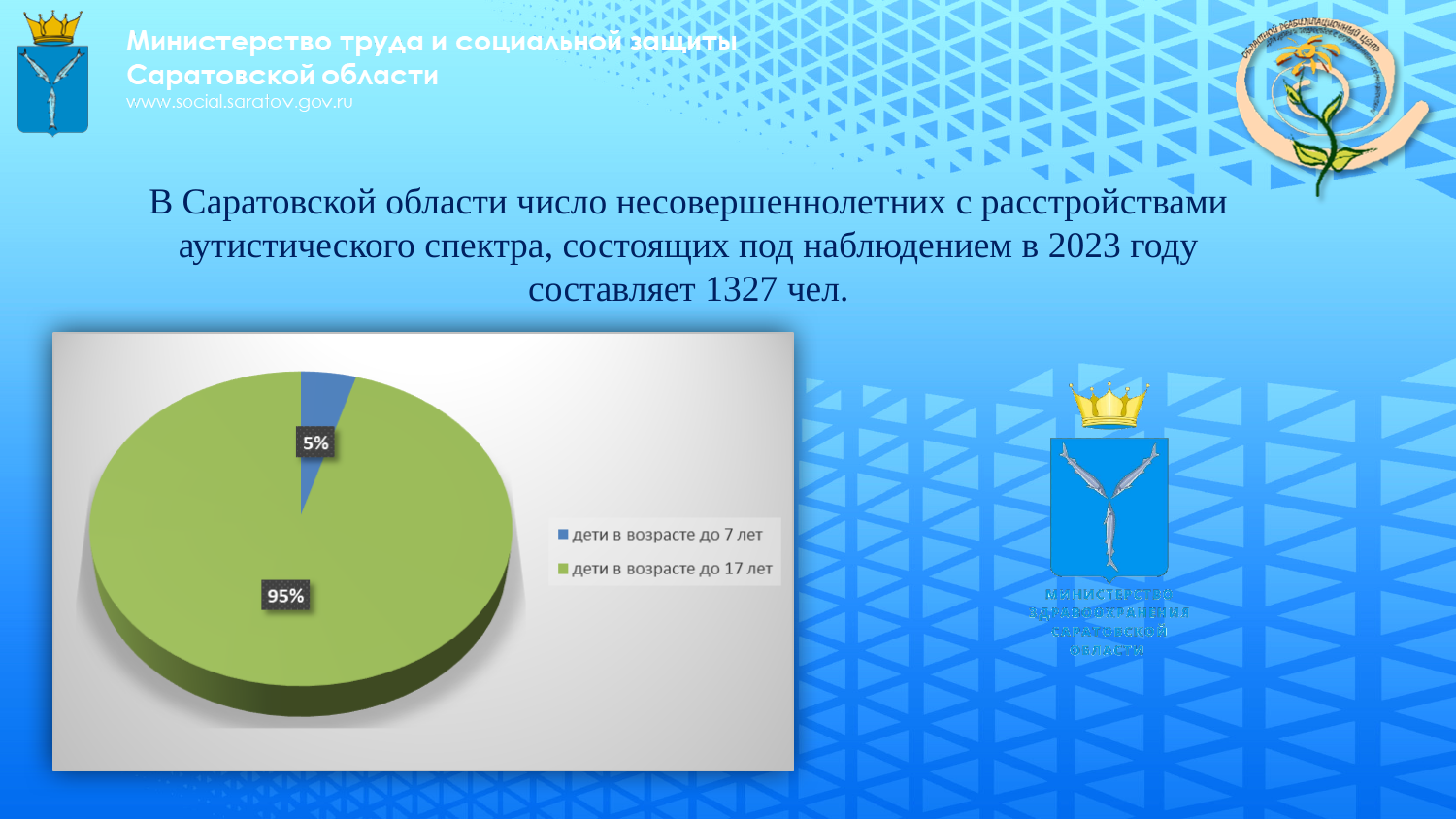
What kind of chart is shown on the slide? pie chart What colour is the slice for "дети в возрасте до 7 лет"? blue What share of the pie is labelled for "дети в возрасте до 17 лет"? 95% How many slices does the pie chart have? 2 Which slice is larger: "дети в возрасте до 7 лет" or "дети в возрасте до 17 лет"? дети в возрасте до 17 лет Which category has the largest slice of the pie? дети в возрасте до 17 лет What is the difference in percentage points between the slice for "дети в возрасте до 17 лет" and the slice for "дети в возрасте до 7 лет"? 90 How many entries does the legend list? 2 What share of the pie is labelled for "дети в возрасте до 7 лет"? 5% Which category has the smallest slice of the pie? дети в возрасте до 7 лет What colour is the slice for "дети в возрасте до 17 лет"? green